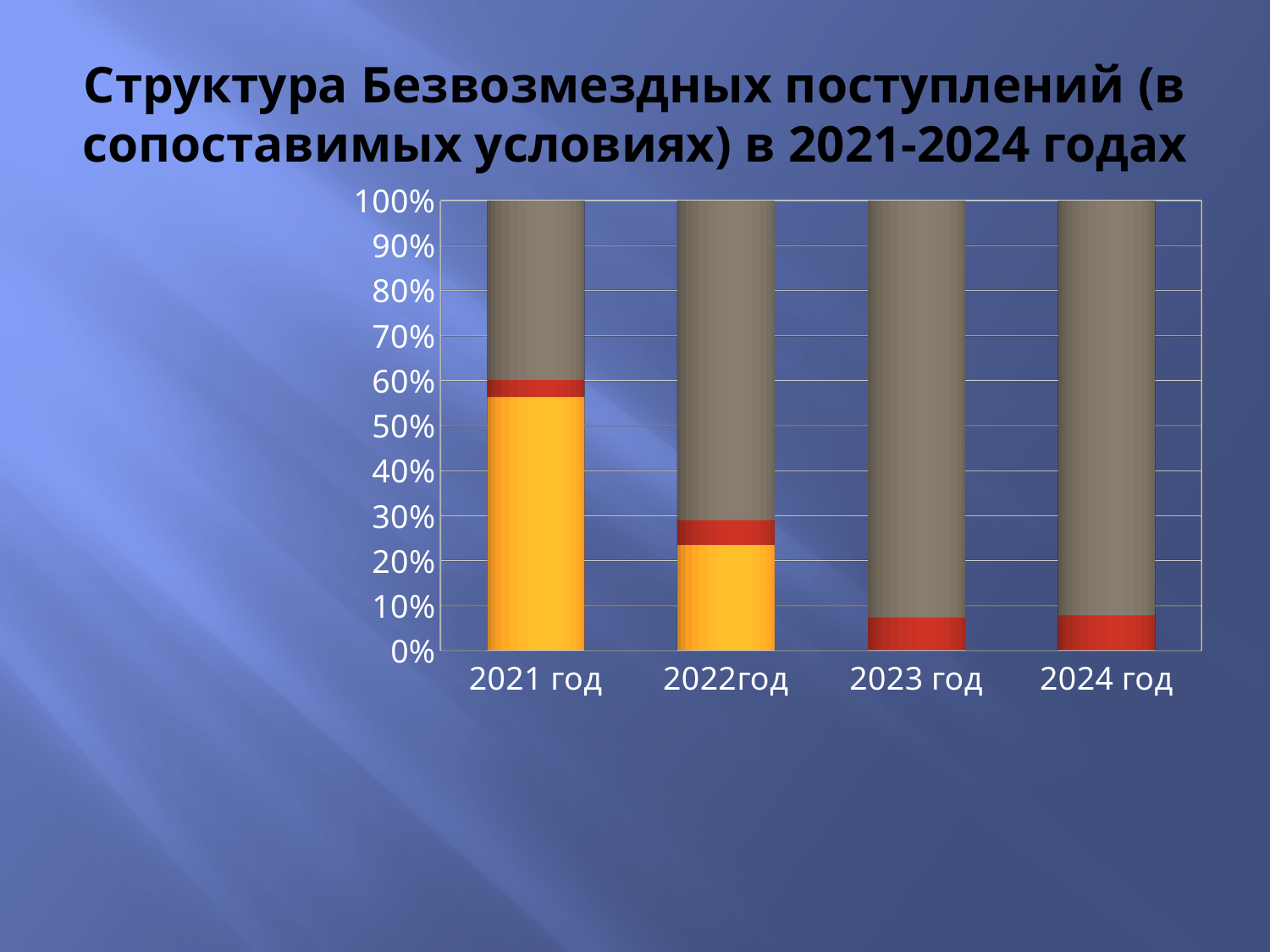
Is the yellow segment larger in 2021 год or in 2022год? 2021 год What kind of chart is shown on the slide? Stacked bar chart What is the title of the chart? Структура Безвозмездных поступлений (в сопоставимых условиях) в 2021-2024 годах Which year has the smallest grey segment? 2021 год What value does the top of every stacked bar reach on the y axis? 100% Is the grey segment for 2024 год greater or less than 80%? greater Is the yellow segment for 2021 год greater or less than 50%? greater How many of the bars contain a yellow segment? 2 Which year has the largest yellow segment? 2021 год How many years (categories) are shown on the x axis? 4 Does the share of the yellow segment rise or fall from 2021 to 2024? fall Is the yellow segment for 2022год greater or less than 30%? less